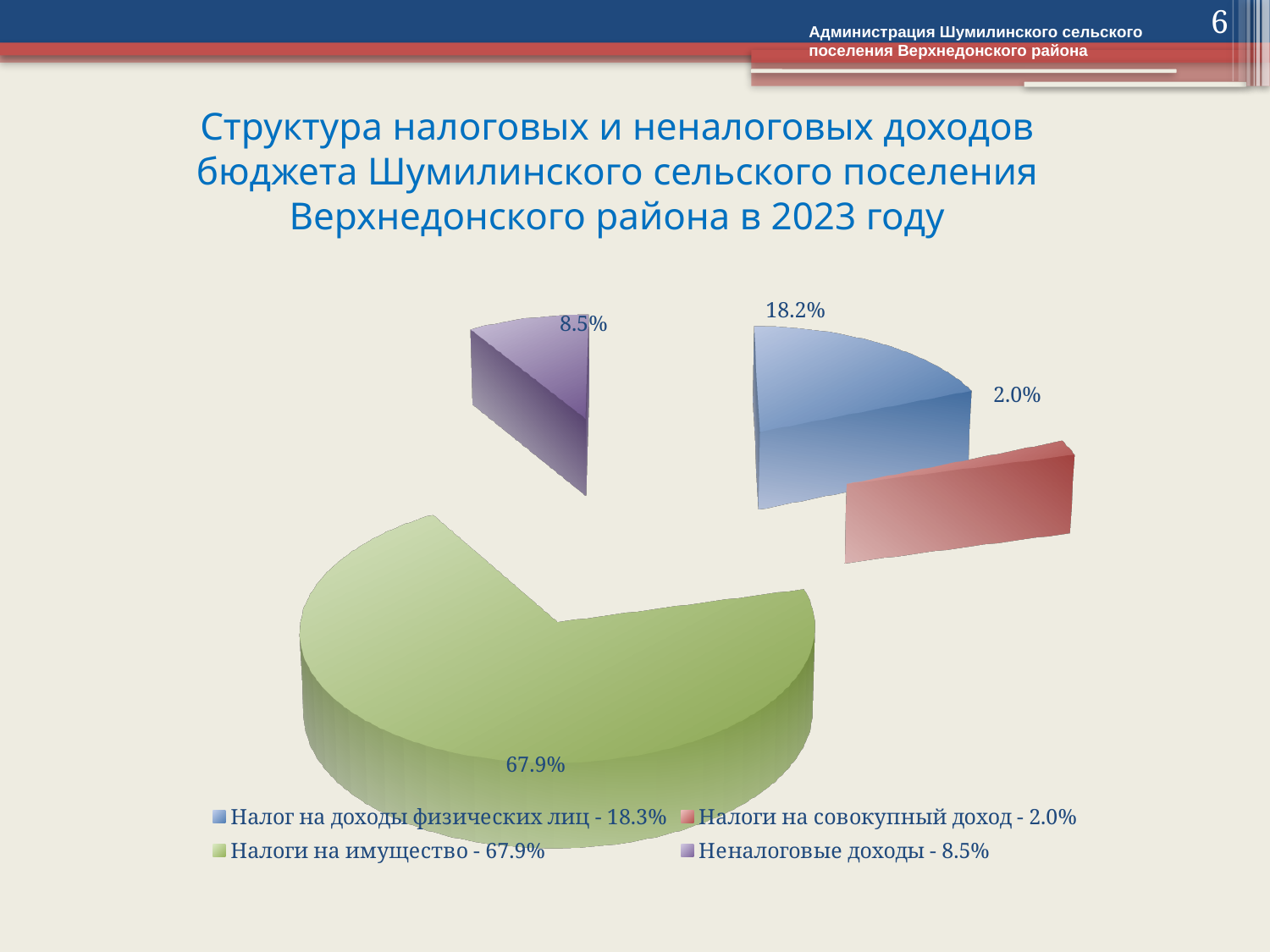
What colour is the slice for Налоги на имущество? green Which category has the smallest slice of the pie? Налоги на совокупный доход Which category has the largest slice of the pie? Налоги на имущество What share of the pie is labelled for Налоги на совокупный доход? 2.0% What year does the chart title say the data refers to? 2023 What is the difference in percentage points between the Налоги на имущество slice (67.9%) and the Неналоговые доходы slice (8.5%)? 59.4 What share of the pie is labelled for Налоги на имущество? 67.9% How many slices does the pie chart have? 4 How many entries does the legend list? 4 Which is larger: the slice for Неналоговые доходы or the slice for Налоги на совокупный доход? Неналоговые доходы What type of chart is shown on the slide? pie chart What share of the pie is labelled for Неналоговые доходы? 8.5%